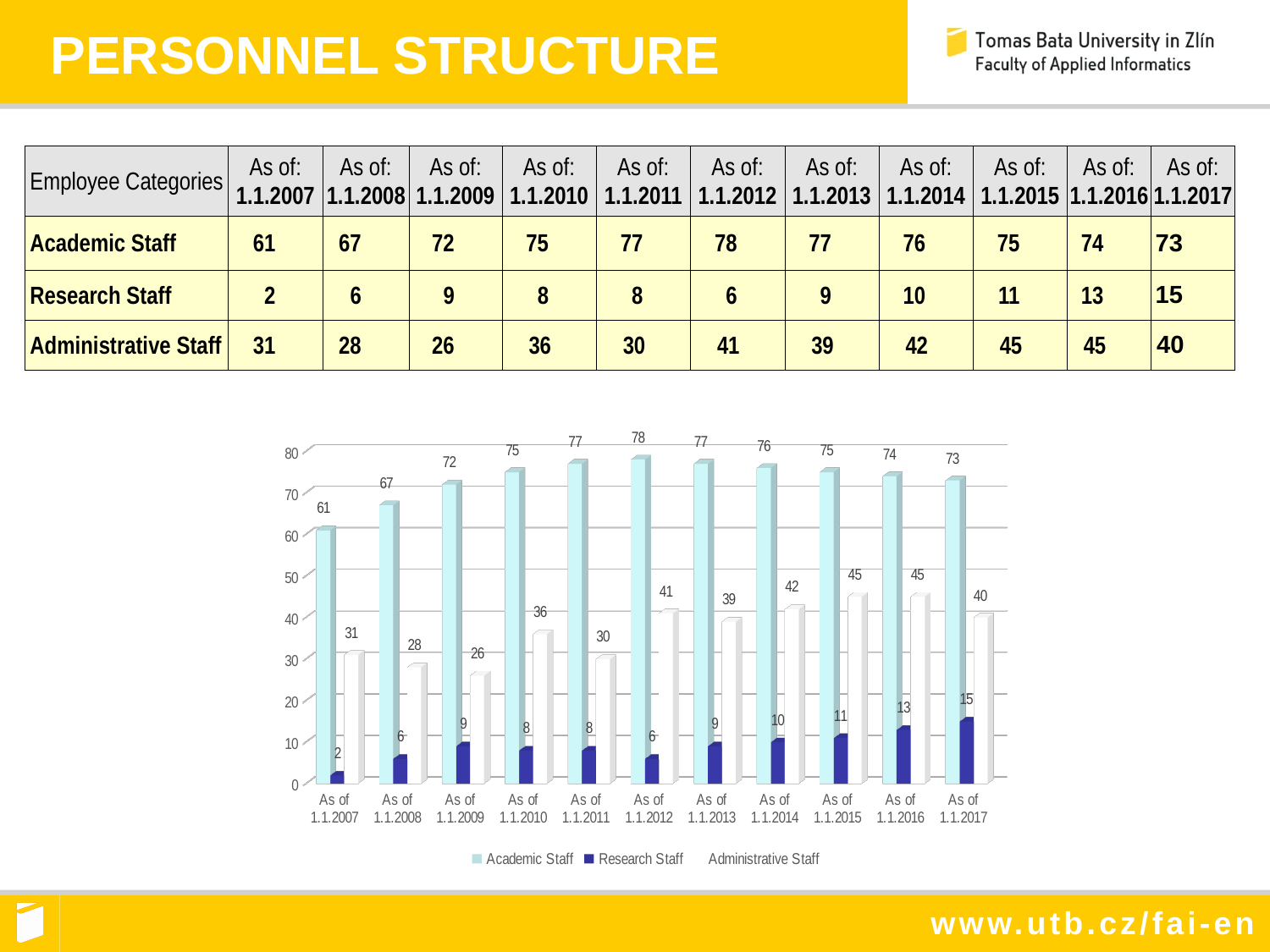
What is the difference between Academic Staff and Administrative Staff as of 1.1.2017? 33 What kind of chart is shown on the slide? Bar chart Which series is shown in dark blue in the chart? Research Staff How many dates (categories) are shown on the x axis of the chart? 11 How many series does the chart legend list? 3 What is the value for Administrative Staff as of 1.1.2010? 36 Which is larger: Administrative Staff as of 1.1.2011 or Administrative Staff as of 1.1.2012? As of 1.1.2012 Does the Research Staff series rise or fall from 1.1.2013 to 1.1.2017? Rise What is the value for Academic Staff as of 1.1.2012? 78 In which year is Research Staff lowest? As of 1.1.2007 In which year does Academic Staff reach its highest value? As of 1.1.2012 What is the value for Research Staff as of 1.1.2017? 15